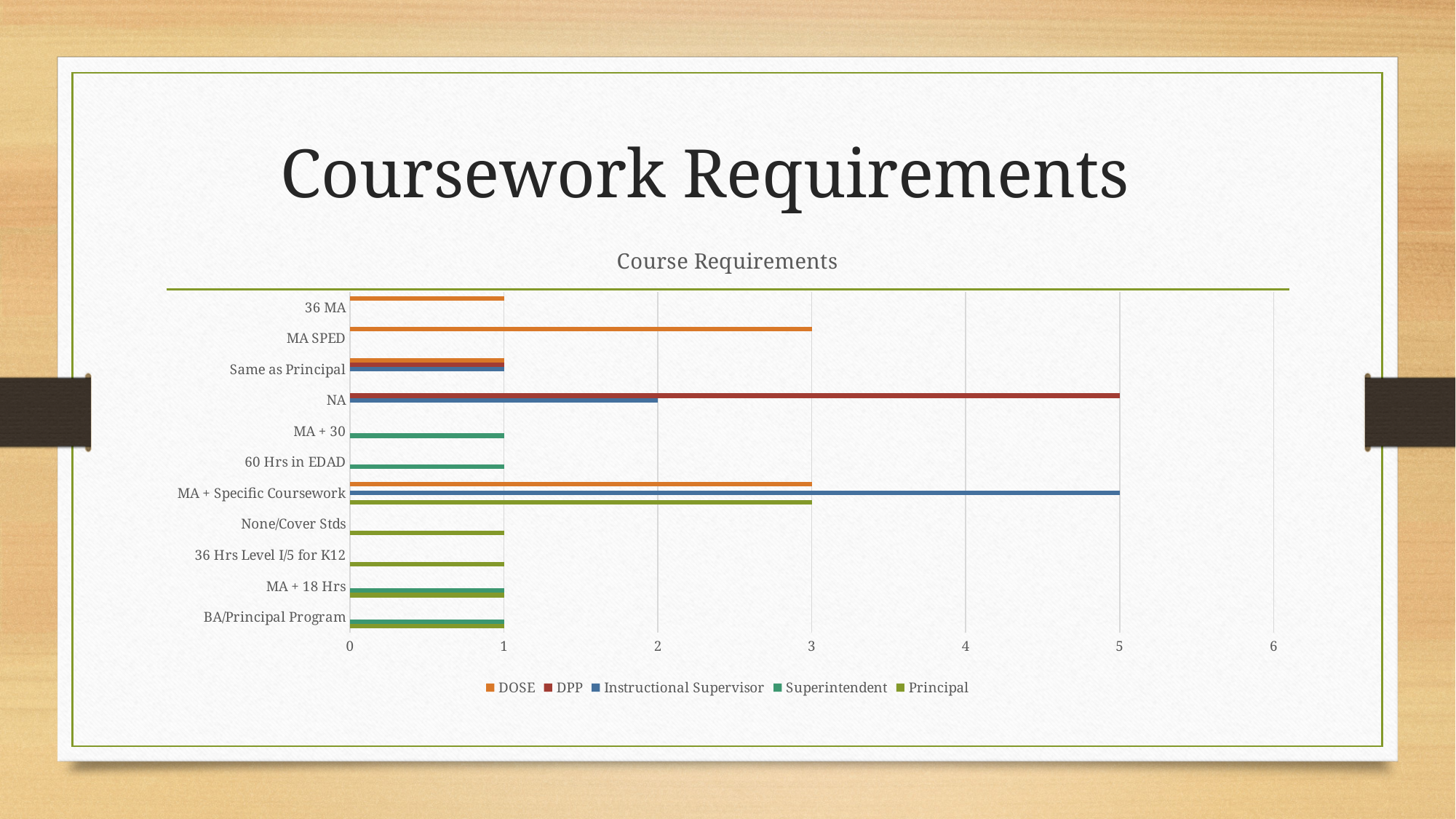
What is the title of the chart? Course Requirements What is the Instructional Supervisor value for MA + Specific Coursework? 5 What is the Instructional Supervisor value for the NA category? 2 Which category has the highest DPP value? NA How many categories are shown on the vertical axis of the chart? 11 For MA + Specific Coursework, which is larger: the Instructional Supervisor value or the Principal value? Instructional Supervisor Is the DOSE value for MA SPED greater or less than 2? greater What is the DPP value for the NA category? 5 What is the difference between the DPP value and the Instructional Supervisor value for the NA category? 3 What type of chart is shown on the slide? bar chart What is the DOSE value for MA SPED? 3 How many series does the legend list? 5